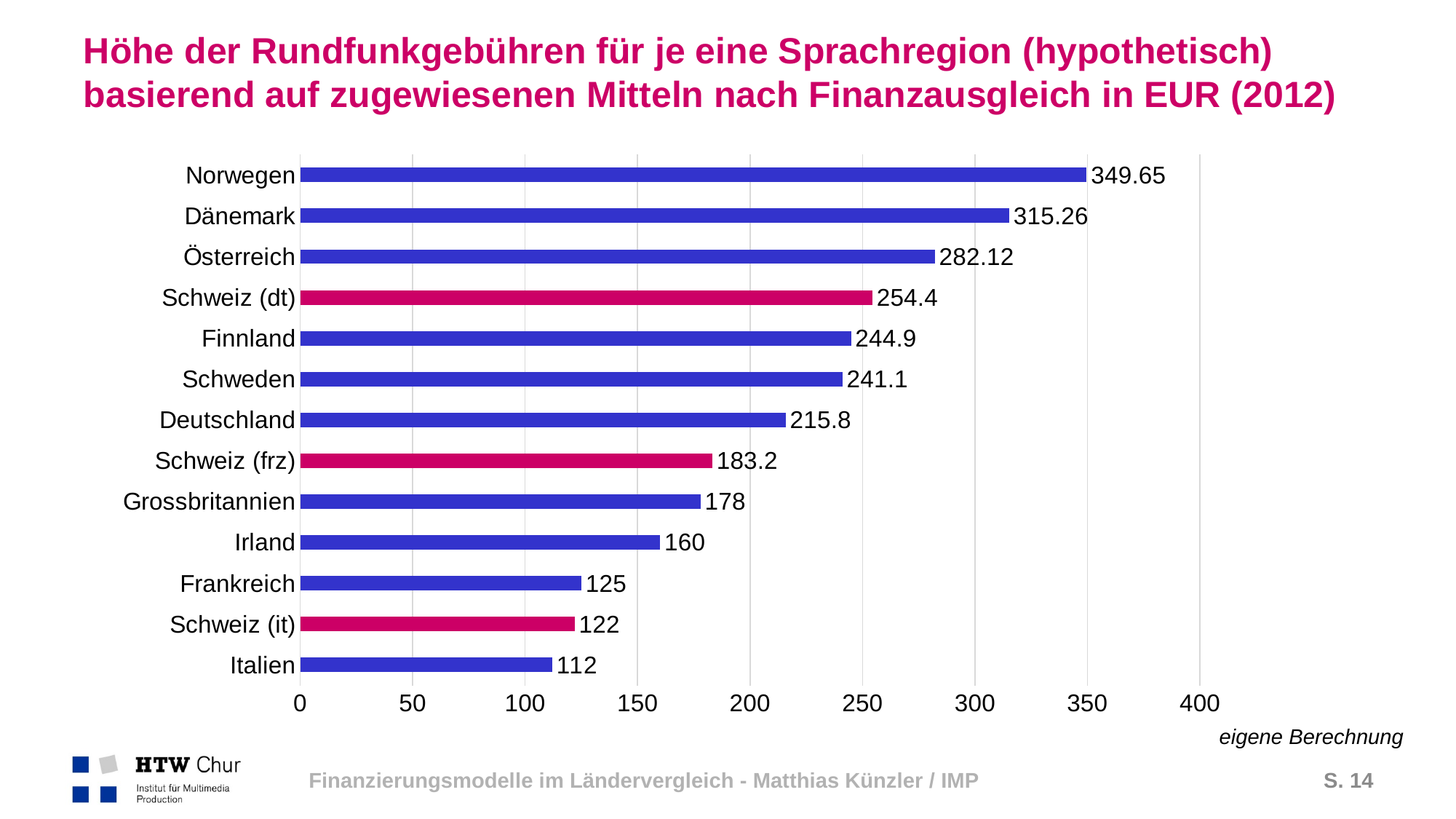
What is the value for Schweiz (frz)? 183.2 Which country or region has the lowest value? Italien Which country or region has the highest value? Norwegen Which bars are coloured differently (pink) from the rest? Schweiz (dt), Schweiz (frz), Schweiz (it) Is the value for Irland greater or less than 150? greater Which is larger, the value for Grossbritannien or the value for Irland? Grossbritannien What kind of chart is shown on the slide? bar chart What is the difference between the values for Schweiz (dt) and Schweiz (frz)? 71.2 What is the value for Deutschland? 215.8 What is the difference between the values for Norwegen and Italien? 237.65 What is the value for Norwegen? 349.65 How many countries or regions are shown in the chart? 13